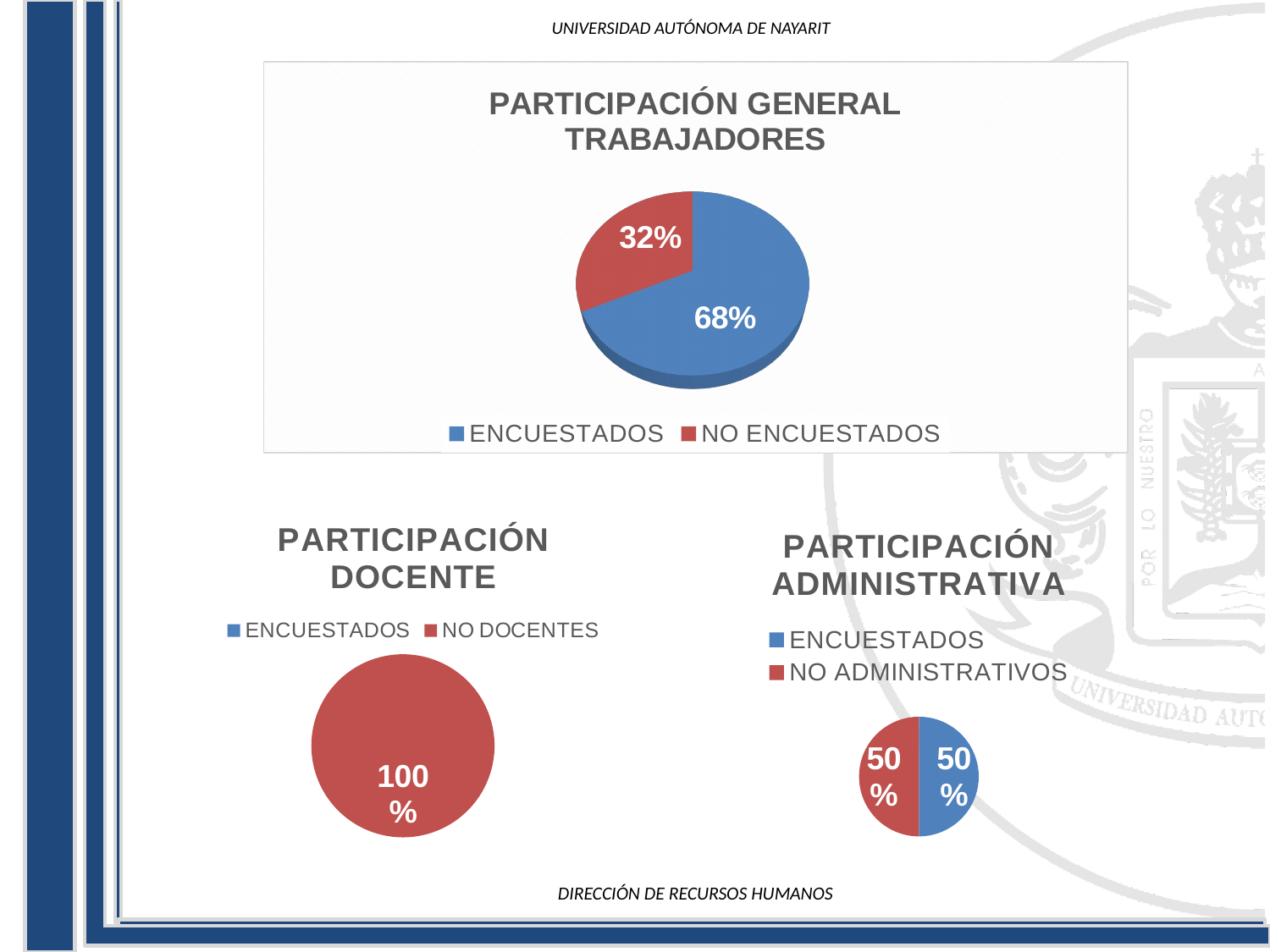
In the PARTICIPACIÓN ADMINISTRATIVA chart, what percentage is shown for ENCUESTADOS? 50% In the PARTICIPACIÓN GENERAL TRABAJADORES chart, what percentage is shown for NO ENCUESTADOS? 32% In the PARTICIPACIÓN DOCENTE chart, which legend entry does the red slice that fills the whole pie correspond to? NO DOCENTES In the PARTICIPACIÓN GENERAL TRABAJADORES chart, which category has the smallest slice? NO ENCUESTADOS In the PARTICIPACIÓN DOCENTE chart, what percentage is shown on the pie? 100% In the PARTICIPACIÓN GENERAL TRABAJADORES chart, what is the difference in percentage points between ENCUESTADOS and NO ENCUESTADOS? 36 What kind of chart is the PARTICIPACIÓN GENERAL TRABAJADORES chart? Pie chart How many pie charts are shown on the slide? 3 In the PARTICIPACIÓN ADMINISTRATIVA chart, what percentage is shown for NO ADMINISTRATIVOS? 50% How many entries does the legend of the PARTICIPACIÓN GENERAL TRABAJADORES chart list? 2 In the PARTICIPACIÓN GENERAL TRABAJADORES chart, what percentage is shown for ENCUESTADOS? 68% In the PARTICIPACIÓN GENERAL TRABAJADORES chart, which category has the largest slice? ENCUESTADOS